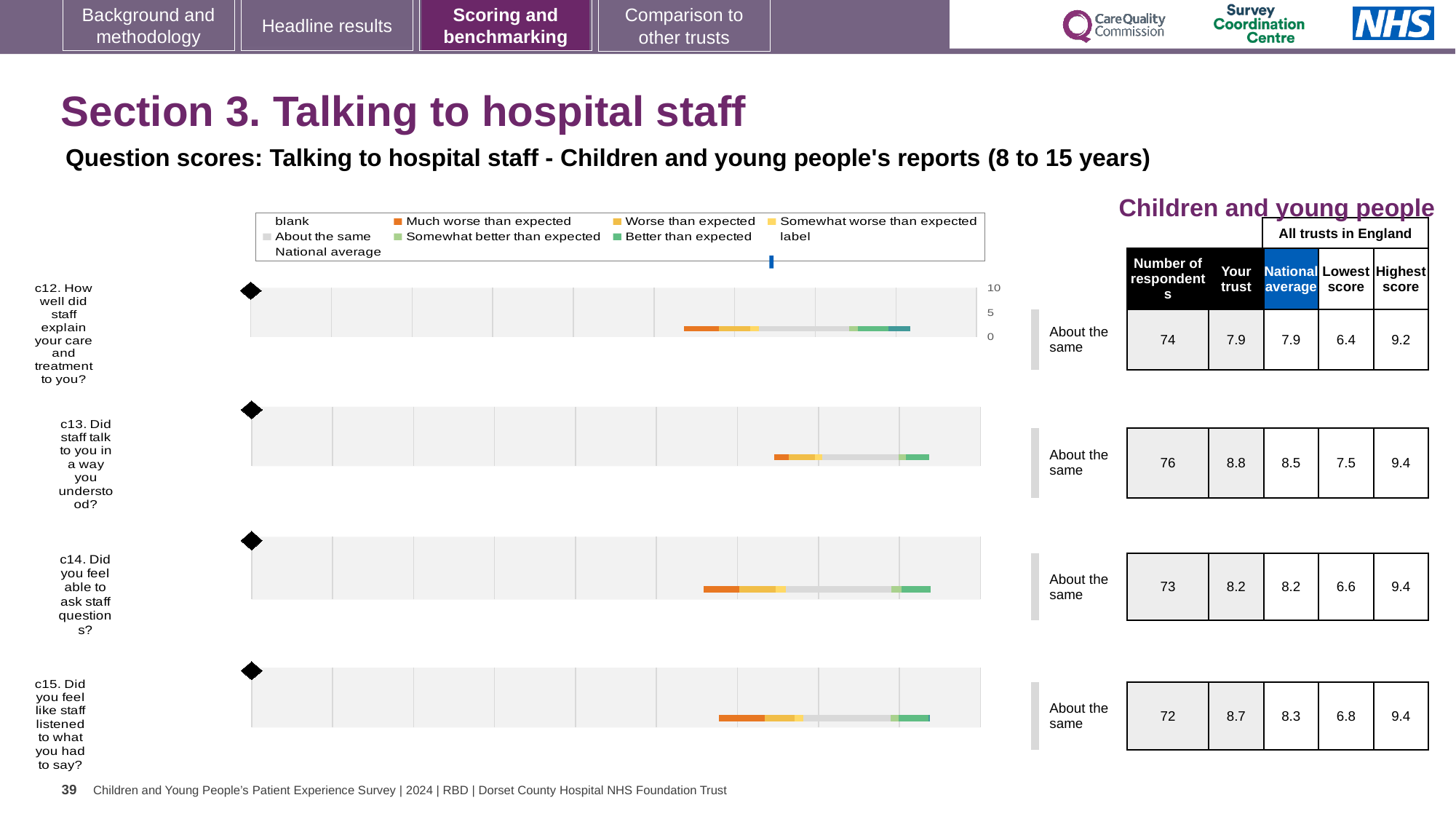
How many survey questions (c12 to c15) are plotted on the slide? 4 What is the 'Your trust' score for c13 (Did staff talk to you in a way you understood?)? 8.8 What is the maximum value shown on the score axis of the charts? 10 What is the number of respondents for c12 (How well did staff explain your care and treatment to you?)? 74 What benchmark label is shown next to the chart for c12? About the same What is the difference between the 'Your trust' score and the national average for c15? 0.4 Which question has the lowest 'Lowest score' across all trusts in England? c12 What kind of chart is used to show the question scores for c12 to c15? Bar chart For c14, is the 'Your trust' score higher than, lower than, or the same as the national average? The same What is the national average score for c15 (Did you feel like staff listened to what you had to say?)? 8.3 Which question has the highest 'Your trust' score? c13 What is the highest score across all trusts in England for c13? 9.4